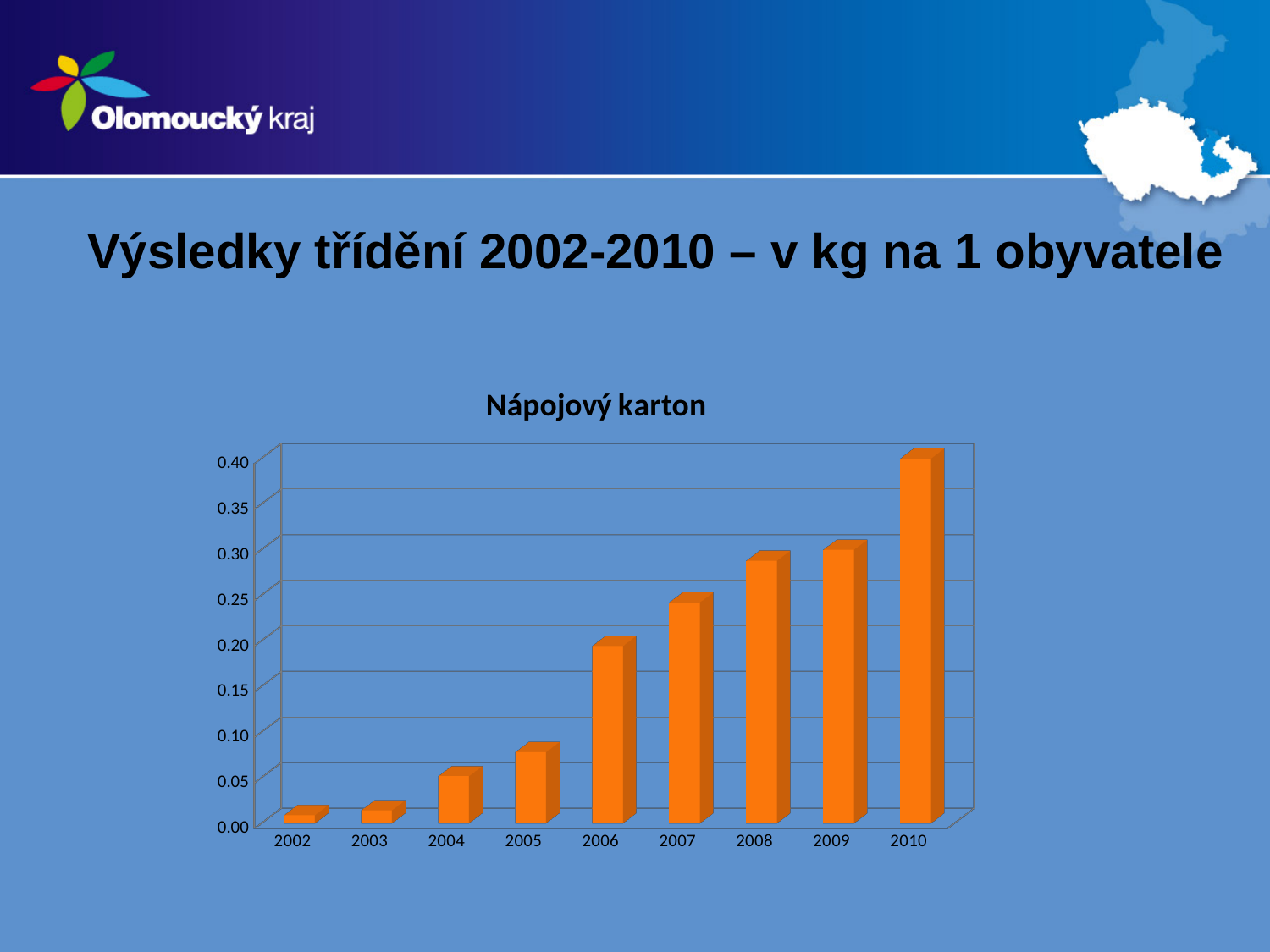
Which year has the larger value, 2005 or 2006? 2006 Which year has the highest value in the chart? 2010 Which year has the larger value, 2009 or 2010? 2010 Is the value for 2004 greater or less than 0.10? less Do the values generally rise or fall from 2002 to 2010? rise Is the value for 2006 greater or less than 0.15? greater How many years are shown on the x axis of the chart? 9 What is the title of the chart? Nápojový karton Is the value for 2002 greater or less than 0.05? less What type of chart is shown on the slide? bar chart